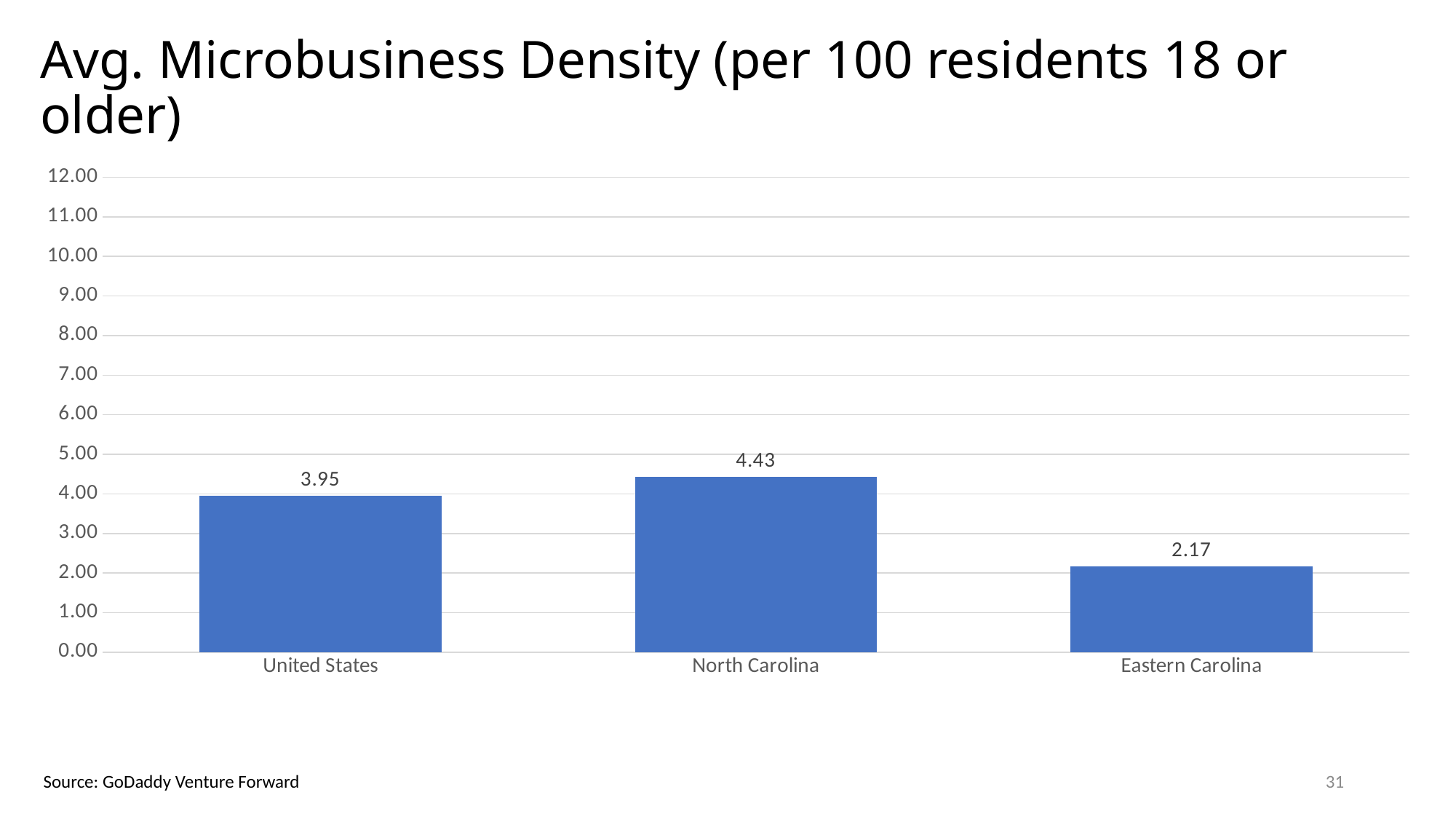
What is the average microbusiness density for the United States? 3.95 What is the average microbusiness density for Eastern Carolina? 2.17 Which region has the lowest average microbusiness density? Eastern Carolina How many regions are shown on the chart? 3 Which is larger, the value for North Carolina or the value for Eastern Carolina? North Carolina What is the average microbusiness density for North Carolina? 4.43 What kind of chart is shown on the slide? Bar chart What is the source cited for the chart? GoDaddy Venture Forward Is the value for Eastern Carolina greater or less than 3.00? less What is the difference between the North Carolina and United States values? 0.48 Which region has the highest average microbusiness density? North Carolina What is the difference between the United States and Eastern Carolina values? 1.78